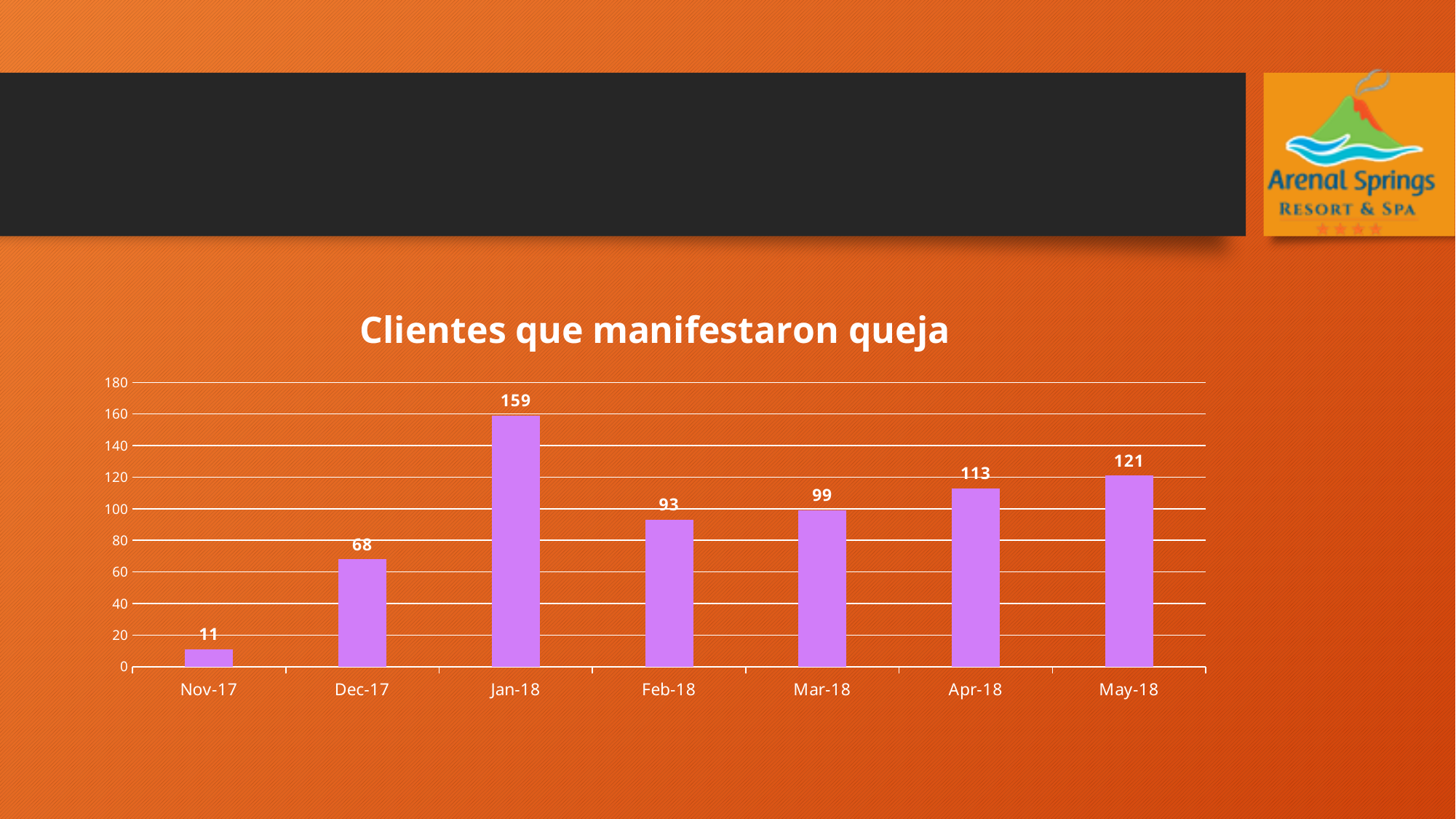
What is the difference between the values for Jan-18 and Feb-18? 66 What is the value for Nov-17? 11 What is the value for Apr-18? 113 Is the value for Feb-18 greater or less than 100? less What kind of chart is shown on the slide? bar chart Which is larger, the value for Mar-18 or the value for Apr-18? Apr-18 What is the title of the chart? Clientes que manifestaron queja Which month has the highest value? Jan-18 What is the value for Jan-18? 159 Which month has the lowest value? Nov-17 What is the difference between the values for May-18 and Dec-17? 53 How many months are shown on the x axis? 7